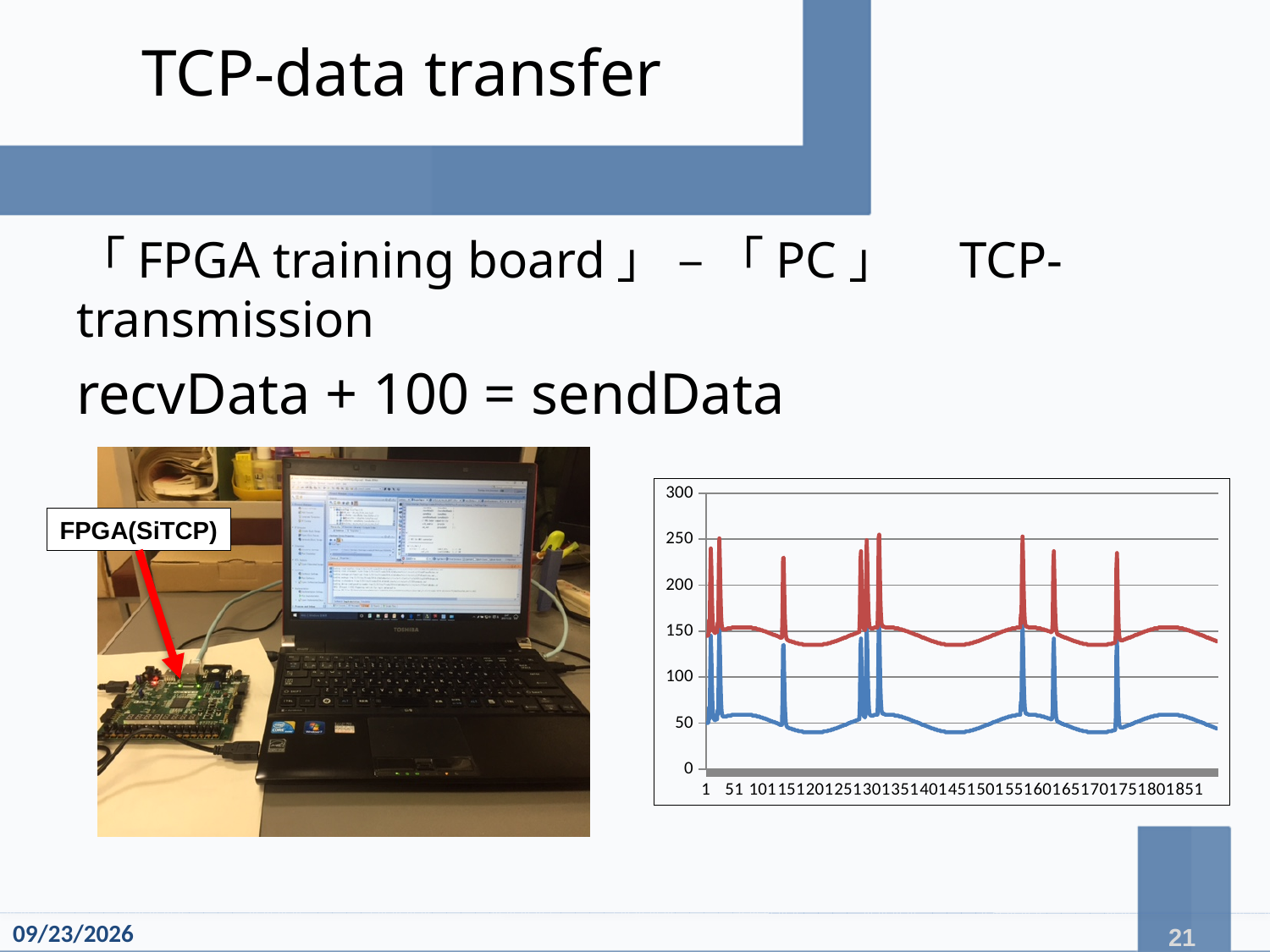
What kind of chart is shown on the right side of the slide? line chart Is the baseline level of the blue line greater or less than 100? less What colours are the two lines in the chart? red and blue Are the peaks of the blue line's spikes greater or less than 200? less How many lines (series) are plotted in the chart? 2 What is the first label on the chart's horizontal axis? 1 What is the last label on the chart's horizontal axis? 851 Are the peaks of the red line's spikes greater or less than 200? greater Which line sits higher on the chart overall, the red line or the blue line? red How many tick labels are shown on the chart's horizontal axis? 18 What is the highest value labelled on the chart's vertical axis? 300